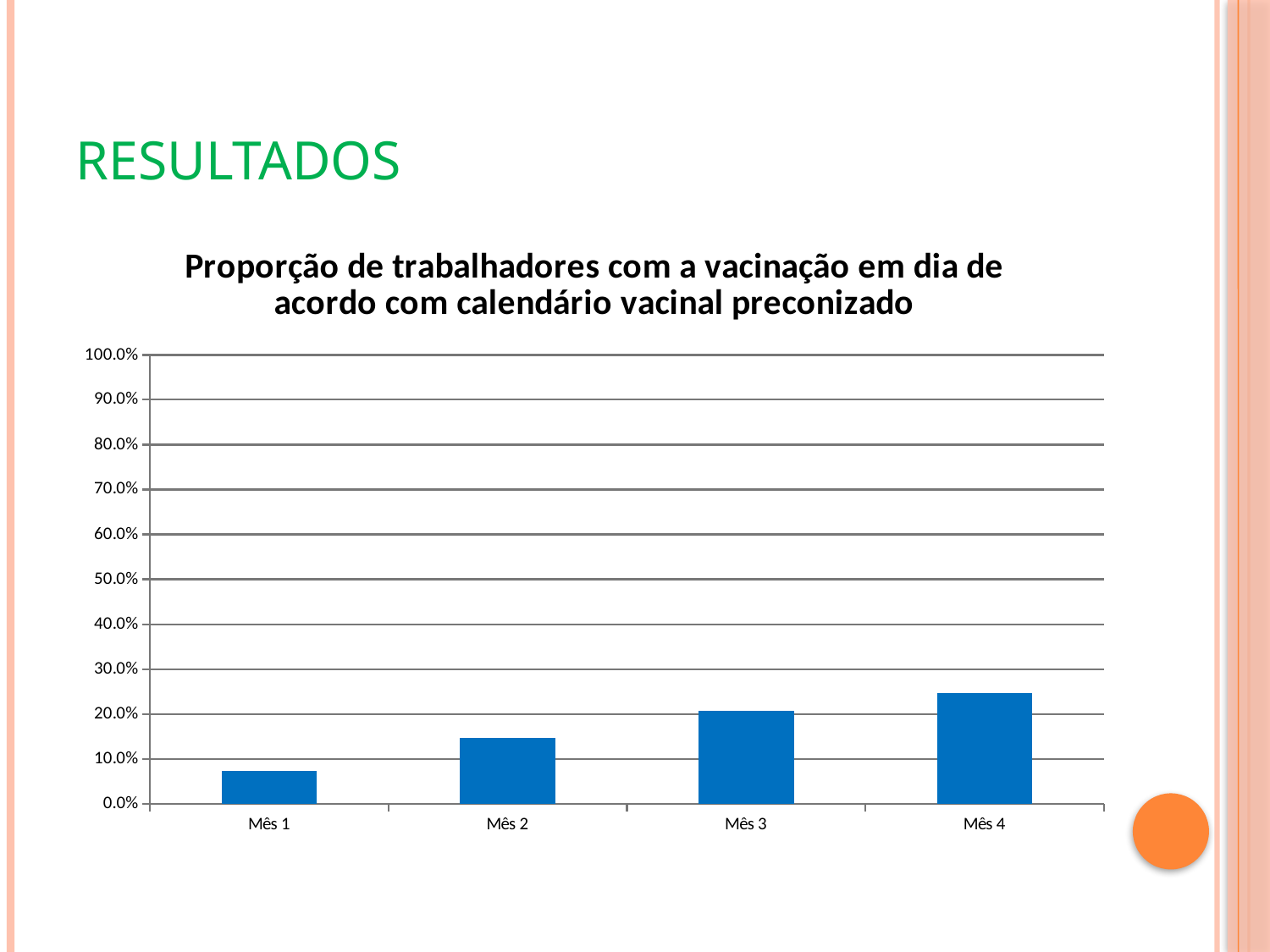
Which month has the lowest proportion of workers with up-to-date vaccination? Mês 1 Is the value for Mês 1 greater or less than 10.0%? less Do the values rise or fall from Mês 1 to Mês 4? rise Is the value for Mês 3 greater or less than 30.0%? less What kind of chart is shown on the slide? bar chart Is the value for Mês 2 greater or less than 20.0%? less Which is larger, the value for Mês 3 or the value for Mês 2? Mês 3 Which month has the highest proportion of workers with up-to-date vaccination? Mês 4 What is the title of the chart? Proporção de trabalhadores com a vacinação em dia de acordo com calendário vacinal preconizado How many categories (months) are shown on the x axis of the chart? 4